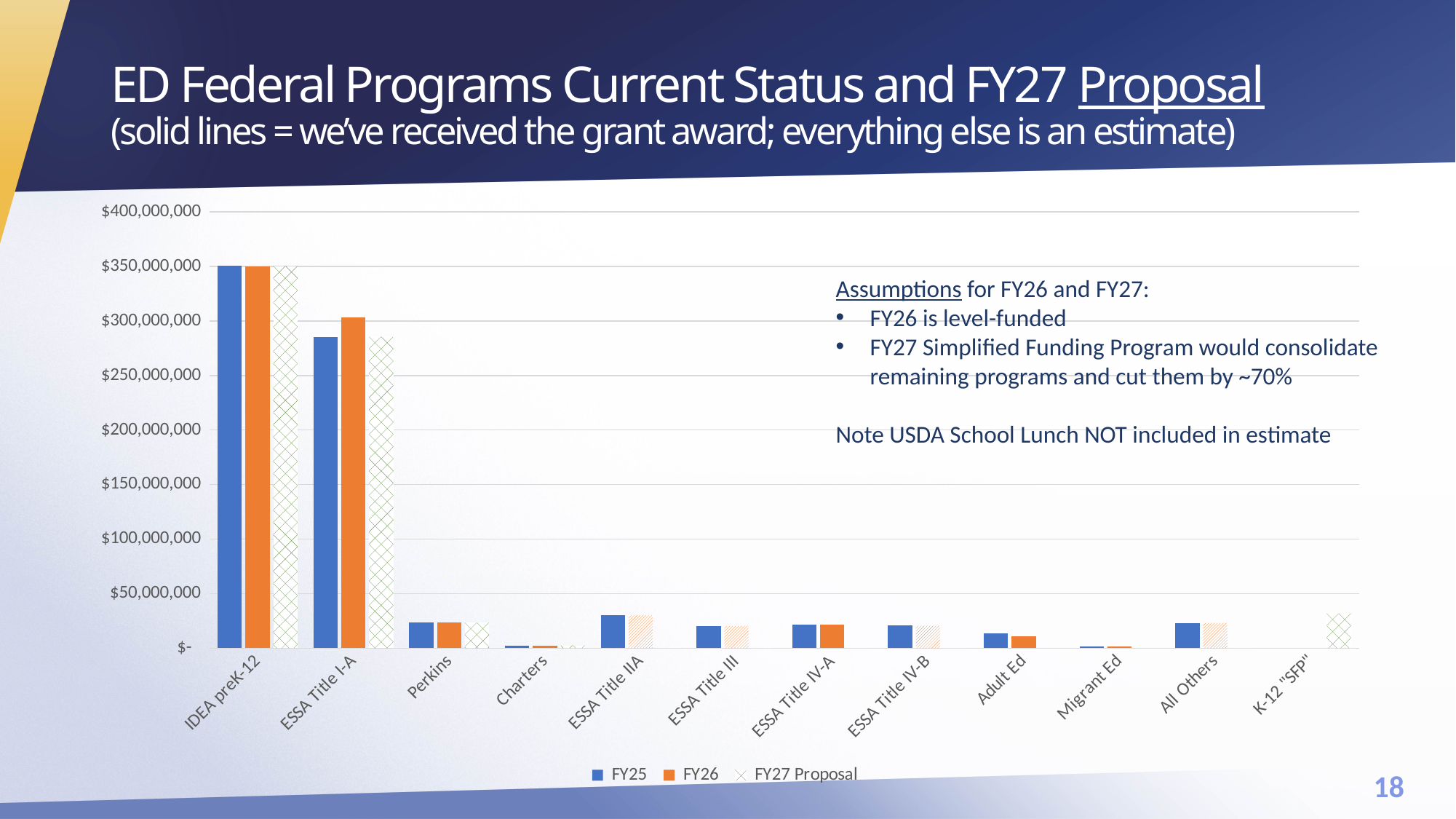
Is the FY26 value for ESSA Title I-A greater or less than $350,000,000? less What kind of chart is shown on the slide? bar chart How many program categories are shown along the x axis? 12 Which category has only an FY27 Proposal bar and no FY25 or FY26 bars? K-12 "SFP" Which is larger: the FY25 value for ESSA Title IIA or the FY25 value for Perkins? ESSA Title IIA Is the FY25 value for ESSA Title I-A greater or less than $250,000,000? greater Is the FY25 value for Perkins greater or less than $50,000,000? less For ESSA Title I-A, which is larger: the FY25 value or the FY26 value? FY26 How many series does the legend list? 3 Which program has the highest FY25 value? IDEA preK-12 What are the three series named in the legend? FY25, FY26, FY27 Proposal